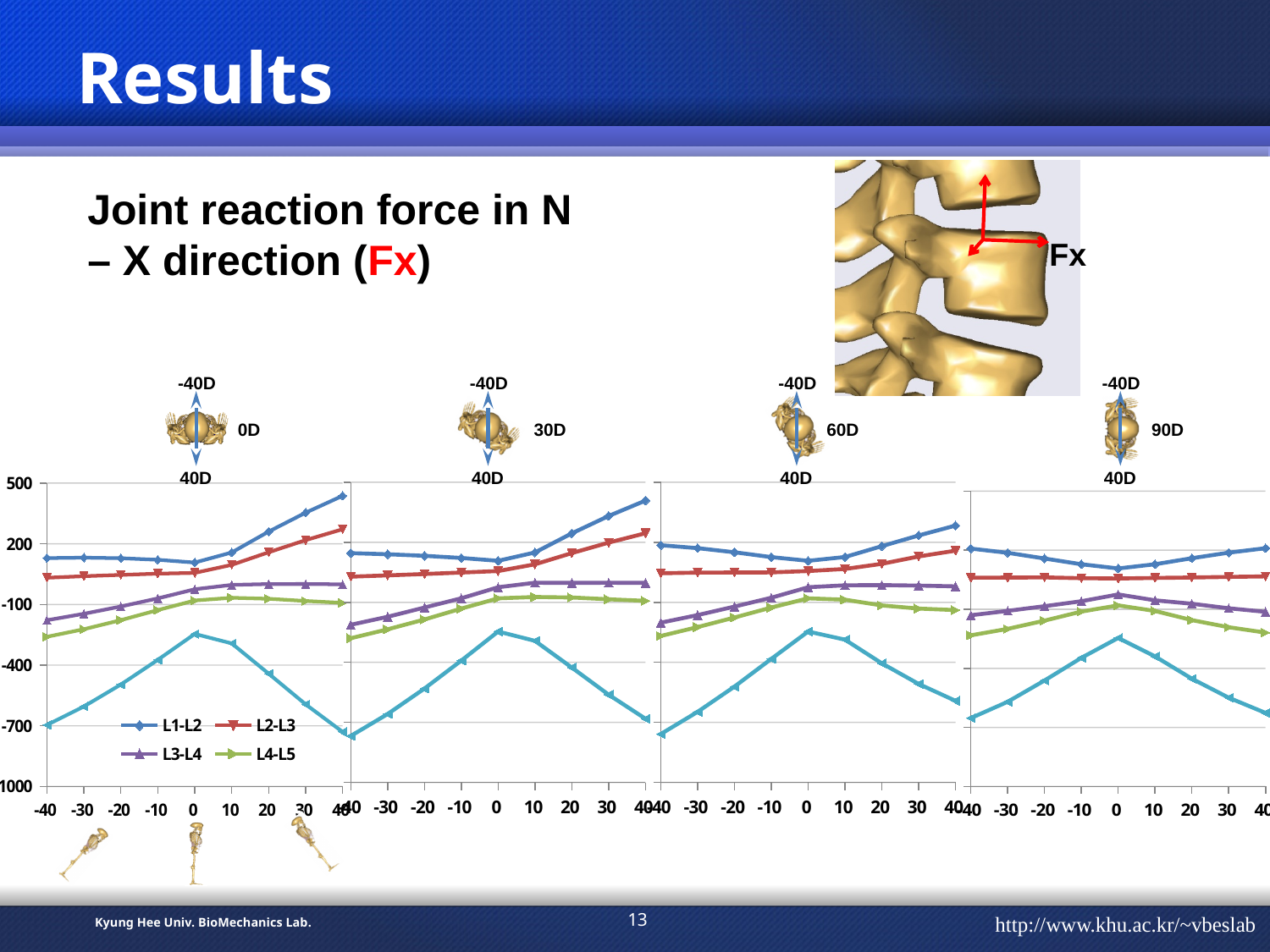
How many series does the legend in the 0D chart list? 4 In the 0D chart, is the value of L1-L2 at x = 40 greater or less than 200? greater What colour is the L1-L2 series in the legend? blue In the 90D chart, is the value of L4-L5 at x = 40 greater or less than -100? less In the 0D chart, is the value of L4-L5 at x = -40 greater or less than -100? less In the 60D chart, does the L2-L3 series rise or fall from x = -40 to x = 40? rise How many chart panels (0D, 30D, 60D, 90D) are shown on the slide? 4 How many x-axis points are plotted in the 0D chart? 9 What kind of chart is used for the 0D panel? line chart In the 0D chart, does the L1-L2 series rise or fall from x = -40 to x = 40? rise